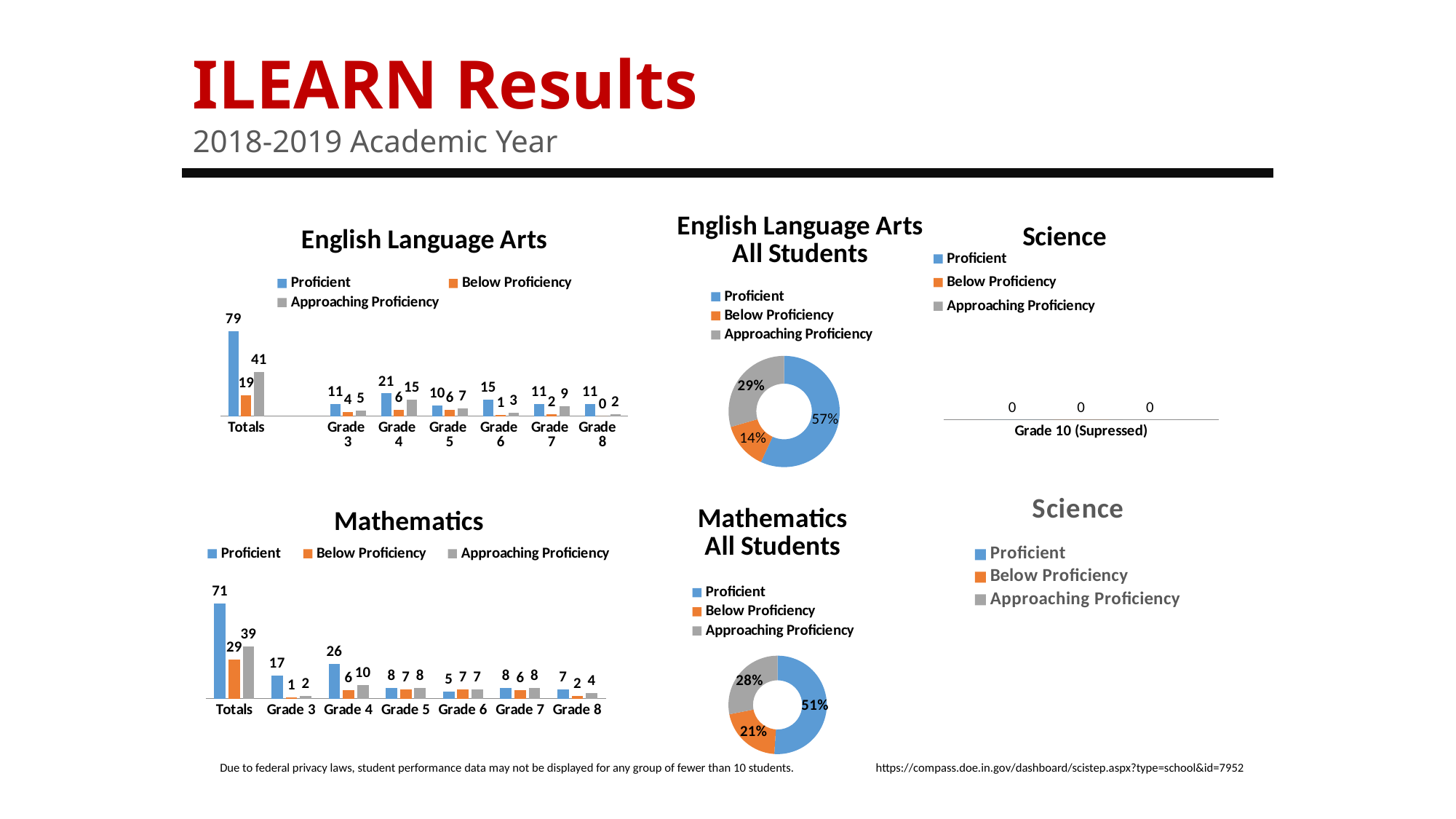
In the Mathematics bar chart, is the Proficient value for Grade 3 larger or smaller than the Proficient value for Grade 8? larger In the Mathematics bar chart, what is the Proficient value for Grade 4? 26 In the Mathematics bar chart, which grade (excluding Totals) has the lowest Proficient value? Grade 6 In the English Language Arts bar chart, what is the Approaching Proficiency value for Grade 4? 15 In the English Language Arts bar chart, which grade (excluding Totals) has the highest Proficient value? Grade 4 In the English Language Arts All Students donut chart, what share is Below Proficiency? 14% In the Mathematics All Students donut chart, what share is Approaching Proficiency? 28% In the English Language Arts All Students donut chart, what share is Proficient? 57% In the Science chart, what value is shown for Grade 10 (Supressed) for each series? 0 In the English Language Arts bar chart, what is the Proficient value for Totals? 79 In the English Language Arts bar chart, what is the difference between the Proficient and Below Proficiency values for Totals? 60 How many series does the legend of the Mathematics bar chart list? 3